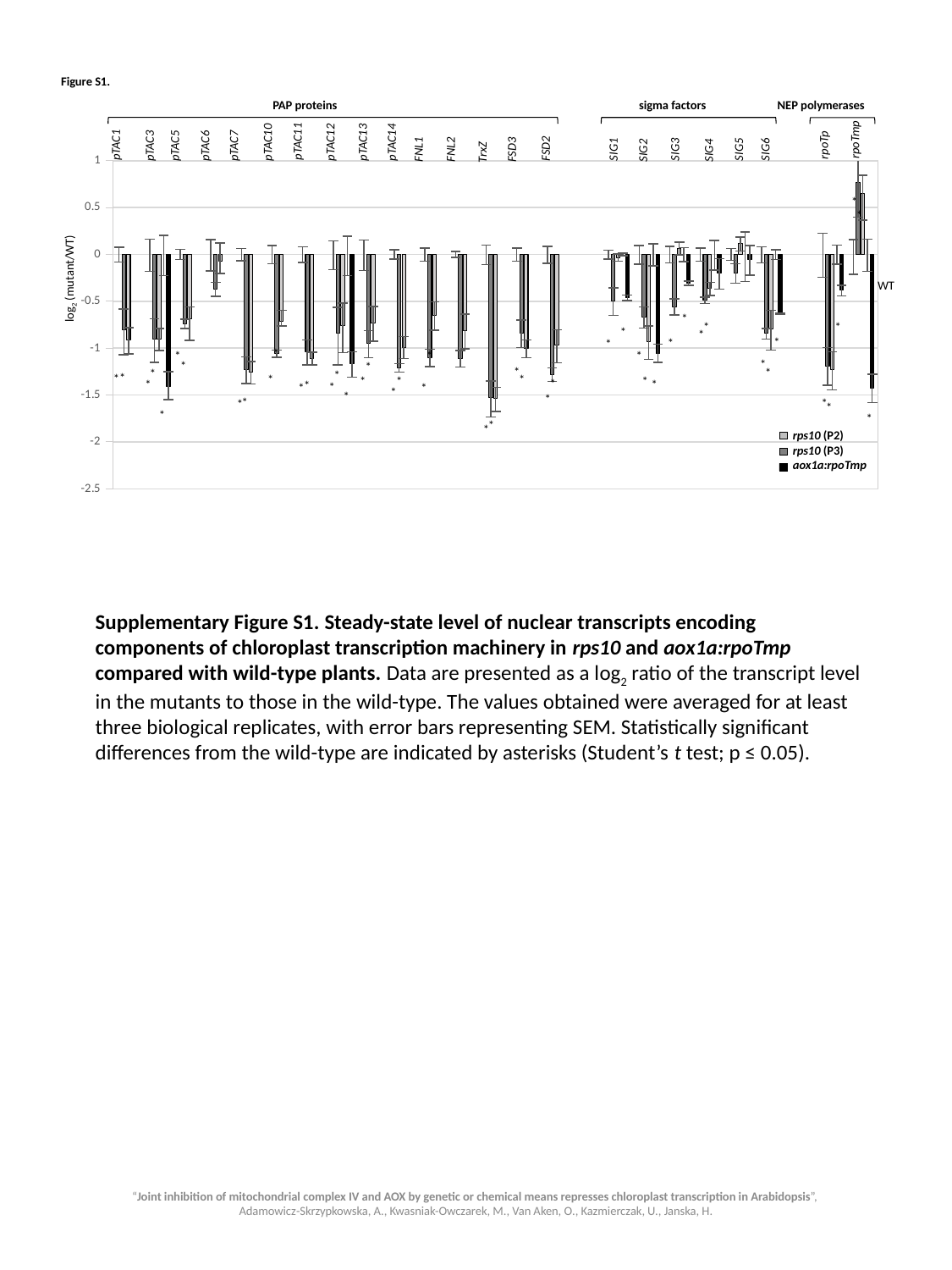
In the rps10 (P3) series, which has the larger value, pTAC6 or TrxZ? pTAC6 Which category has the highest value in the aox1a:rpoTmp series? SIG5 How many categories are grouped under the 'sigma factors' heading? 6 How many gene categories are plotted along the x axis of the chart? 23 How many categories are grouped under the 'NEP polymerases' heading? 2 Is the value for rpoTmp in the aox1a:rpoTmp series greater or less than 0? less What kind of chart is shown on the slide? bar chart What is the label of the y axis of the chart? log2 (mutant/WT) How many series does the chart legend list? 3 Is the value for TrxZ in the rps10 (P3) series greater or less than -1? less Is the value for pTAC6 in the rps10 (P3) series greater or less than -0.5? greater